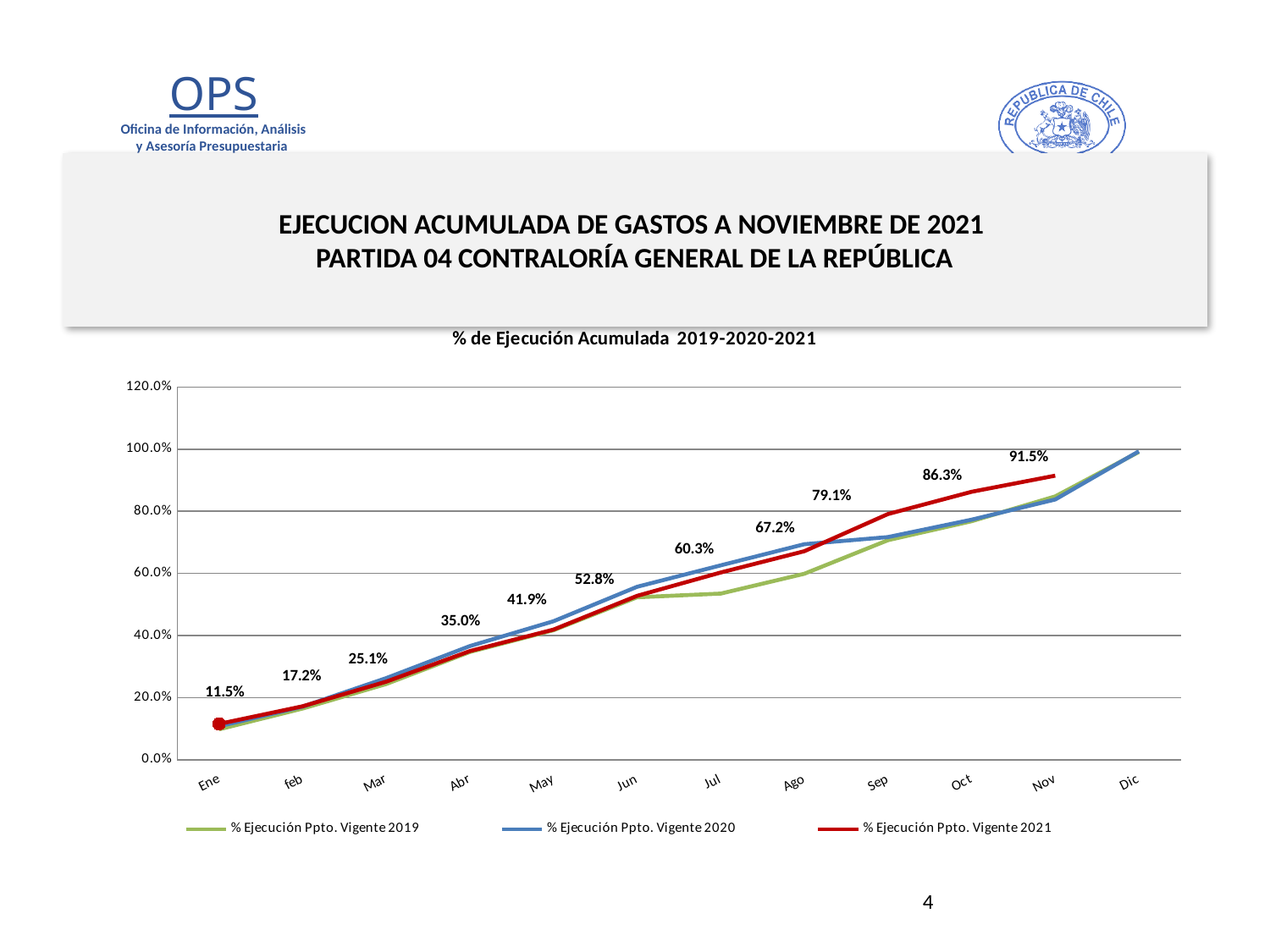
What is the difference between the 2021 values for Nov and Oct? 5.2% What is the value for % Ejecución Ppto. Vigente 2021 in Jun? 52.8% What is the value for % Ejecución Ppto. Vigente 2021 in Nov? 91.5% How many months are shown on the x axis? 12 Is the value for % Ejecución Ppto. Vigente 2019 in Sep greater or less than 80%? less What is the difference between the 2021 values for Sep and Ago? 11.9% What is the value for % Ejecución Ppto. Vigente 2021 in Ene? 11.5% What is the title of the chart? % de Ejecución Acumulada 2019-2020-2021 How many series does the legend list? 3 Which month has the highest labelled value for % Ejecución Ppto. Vigente 2021? Nov What kind of chart is shown on the slide? line chart Do the values for % Ejecución Ppto. Vigente 2021 rise or fall from Ene to Nov? rise